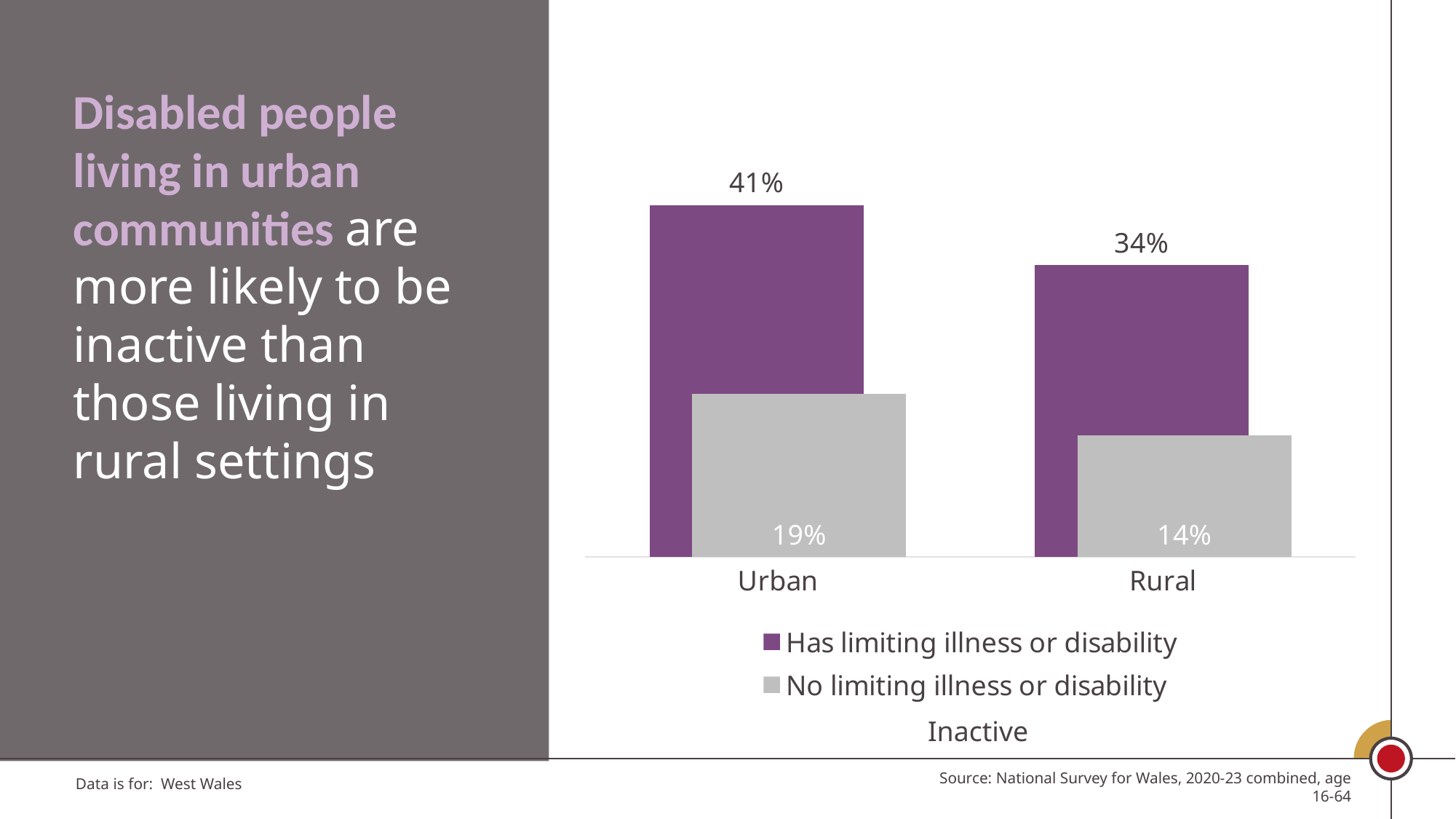
What kind of chart is shown on the slide? Bar chart What is the value for Rural in the 'No limiting illness or disability' series? 14% What is the difference between the 'Has limiting illness or disability' and 'No limiting illness or disability' values for Urban? 22% What is the difference between the Urban and Rural values for 'Has limiting illness or disability'? 7% Which category has the lowest value for 'No limiting illness or disability'? Rural How many series does the legend list? 2 What is the value for Urban in the 'Has limiting illness or disability' series? 41% Which is larger: the Rural value for 'Has limiting illness or disability' or the Urban value for 'No limiting illness or disability'? Rural value for 'Has limiting illness or disability' How many categories are shown on the x axis? 2 Which category has the highest value for 'Has limiting illness or disability'? Urban What is the value for Rural in the 'Has limiting illness or disability' series? 34% What is the value for Urban in the 'No limiting illness or disability' series? 19%